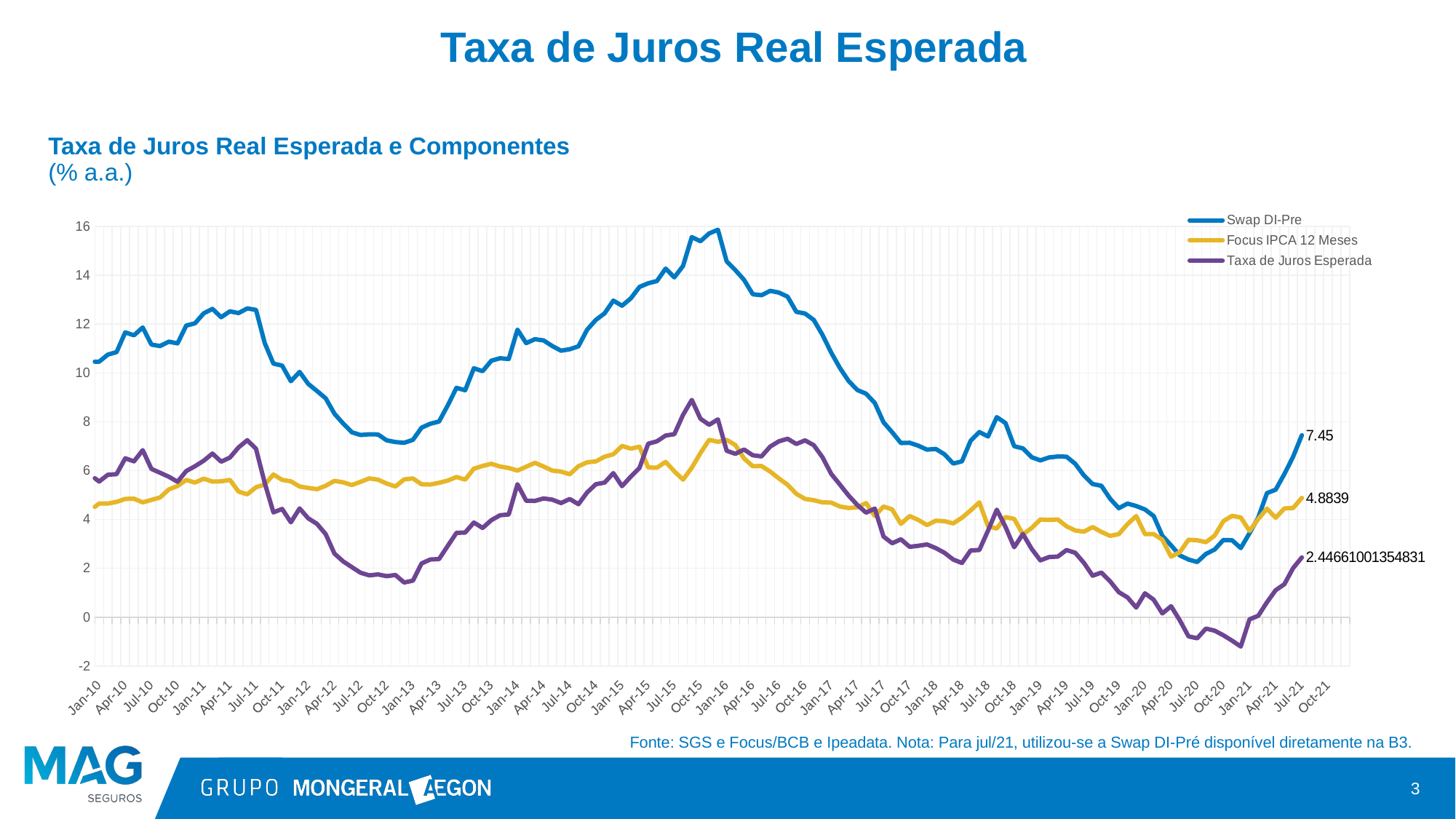
What is the last labelled value of the Focus IPCA 12 Meses series? 4.8839 Is the value of Taxa de Juros Esperada around Oct-20 greater or less than 0? less Does the Swap DI-Pre series rise or fall between Jan-16 and Jan-20? fall What is the difference between the final labelled values of Swap DI-Pre (7.45) and Focus IPCA 12 Meses (4.8839)? 2.5661 Is the value of Swap DI-Pre around Oct-15 greater or less than 14? greater What is the last labelled value of the Taxa de Juros Esperada series? 2.44661001354831 How many series does the legend list? 3 What unit is given under the chart title 'Taxa de Juros Real Esperada e Componentes'? (% a.a.) Which series has the lowest labelled value at the end of the chart? Taxa de Juros Esperada Which series has the highest labelled value at the end of the chart? Swap DI-Pre What kind of chart is shown on the slide? line chart What is the last labelled value of the Swap DI-Pre series? 7.45